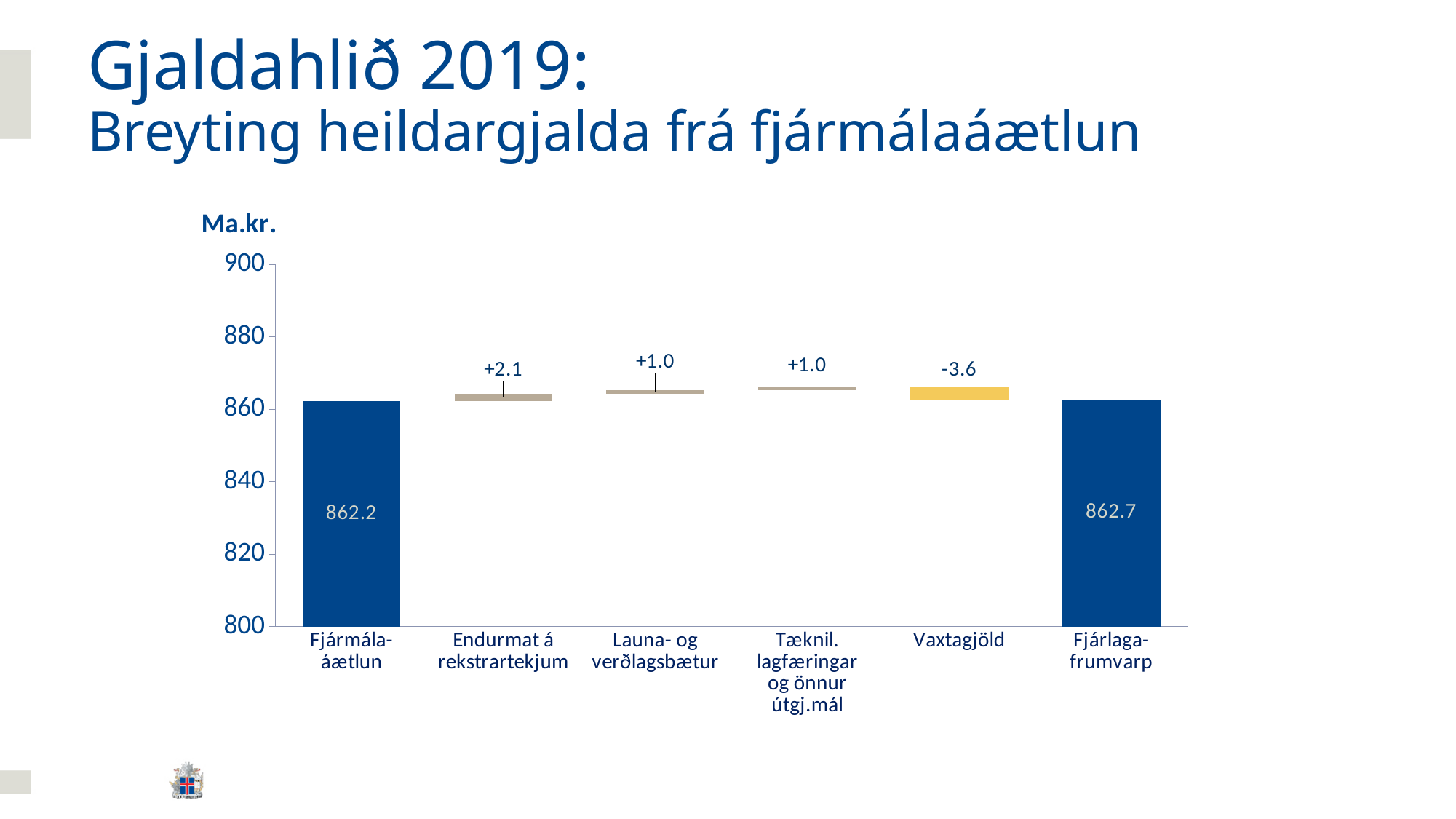
What change is shown for Vaxtagjöld? -3.6 What change is shown for Launa- og verðlagsbætur? +1.0 What is the value for Fjárlagafrumvarp? 862.7 Which is larger, the value for Fjárlagafrumvarp or the value for Fjármálaáætlun? Fjárlagafrumvarp Which adjustment category shows the largest positive change? Endurmat á rekstrartekjum How many categories are shown on the x axis? 6 Which adjustment category shows a negative change? Vaxtagjöld What kind of chart is shown on the slide? Bar chart (waterfall) What is the value for Fjármálaáætlun? 862.2 What unit is shown above the y axis? Ma.kr. What is the difference between the Fjárlagafrumvarp value and the Fjármálaáætlun value? 0.5 What change is shown for Endurmat á rekstrartekjum? +2.1